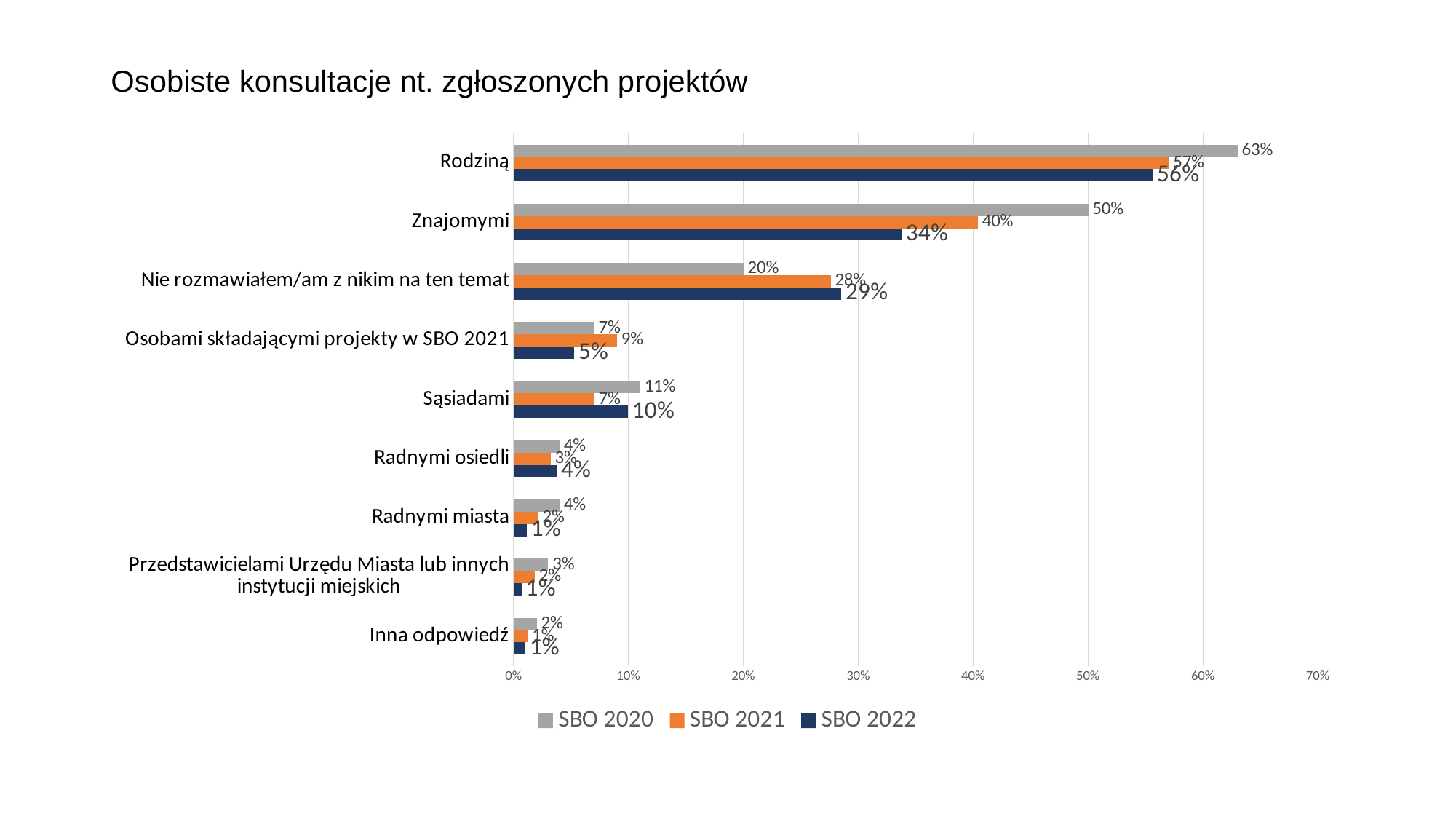
What is the value for Znajomymi in the SBO 2022 series? 34% How many series does the legend list? 3 What is the value for Rodziną in the SBO 2020 series? 63% Is the SBO 2022 value for Rodziną greater or less than 50%? greater What is the value for Sąsiadami in the SBO 2022 series? 10% What is the value for 'Nie rozmawiałem/am z nikim na ten temat' in the SBO 2021 series? 28% For 'Nie rozmawiałem/am z nikim na ten temat', which is larger: the SBO 2020 value or the SBO 2021 value? SBO 2021 Which category has the highest value in the SBO 2020 series? Rodziną What is the title of the slide? Osobiste konsultacje nt. zgłoszonych projektów How many categories are shown on the chart? 9 What kind of chart is shown on the slide? bar chart What is the difference between the SBO 2020 and SBO 2022 values for Znajomymi? 16 percentage points